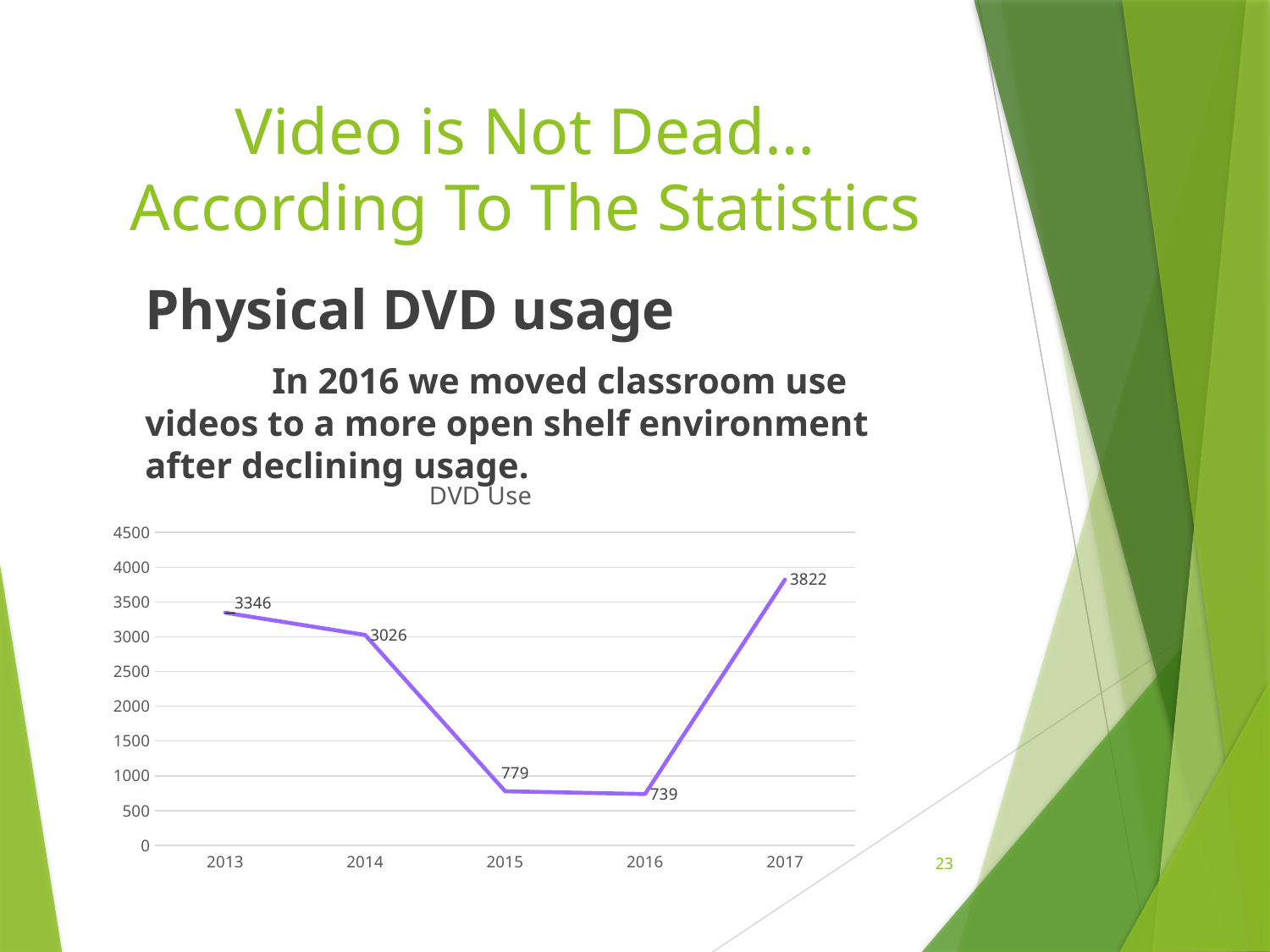
Which year has a larger DVD Use value, 2014 or 2015? 2014 What is the difference between the DVD Use values for 2013 and 2014? 320 What is the DVD Use value for 2017? 3822 Is the DVD Use value for 2016 greater or less than 1000? less What is the DVD Use value for 2013? 3346 What is the title of the chart? DVD Use How many years are plotted on the DVD Use chart? 5 Which year has the highest DVD Use value? 2017 Which year has the lowest DVD Use value? 2016 What is the DVD Use value for 2015? 779 What is the difference between the DVD Use values for 2017 and 2016? 3083 What kind of chart is the DVD Use chart? line chart